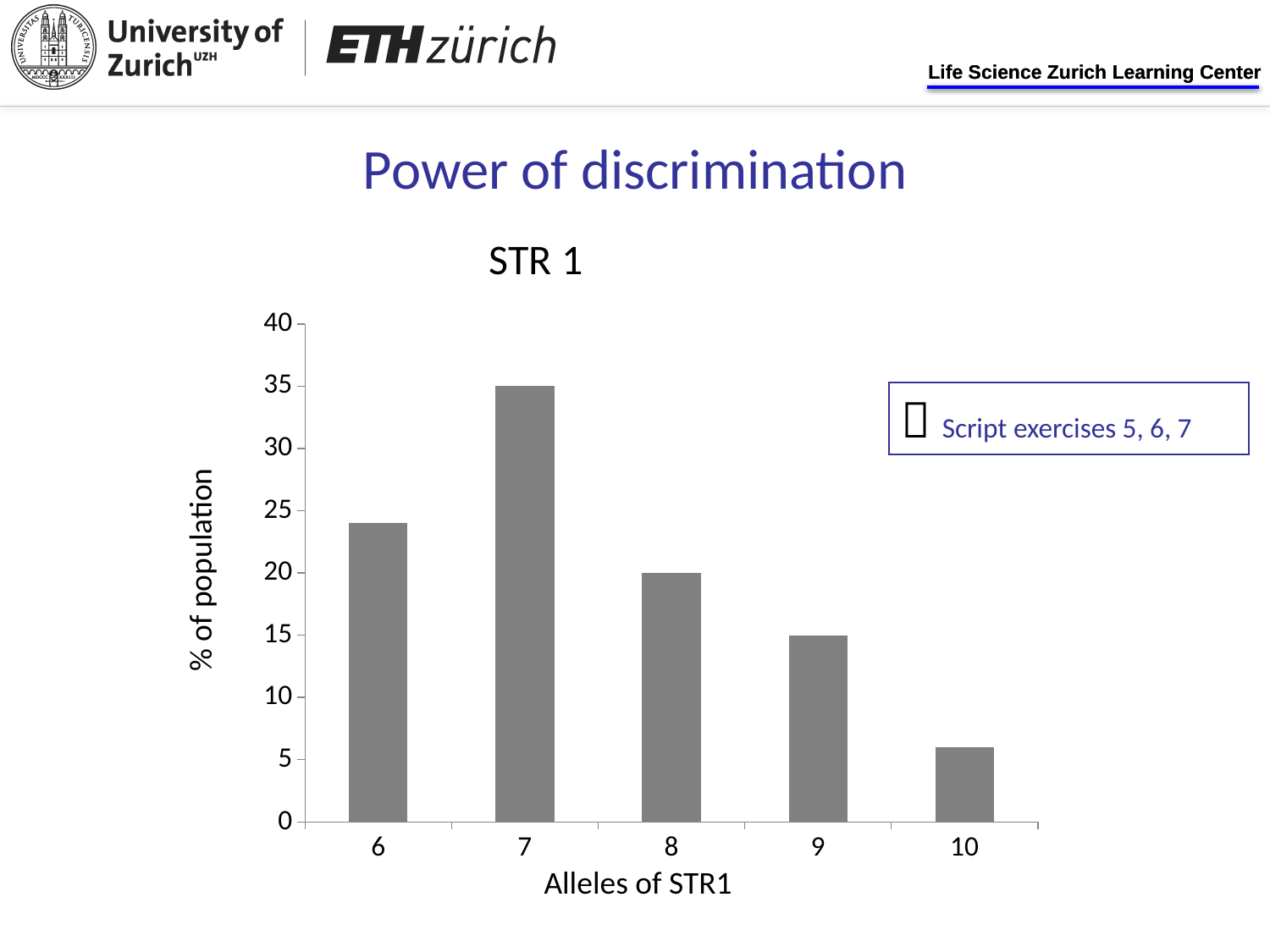
Is the value for allele 6 greater or less than 20? greater What is the difference in % of population between allele 7 and allele 8? 15 What is the % of population for allele 7? 35 What is the % of population for allele 8? 20 What is the title of the chart? STR 1 Which allele has the highest % of population? 7 Which allele has the lowest % of population? 10 What is the % of population for allele 9? 15 Is the value for allele 10 greater or less than 10? less What is the label of the y axis? % of population How many alleles (categories) are plotted on the x axis? 5 What type of chart is shown on the slide? bar chart